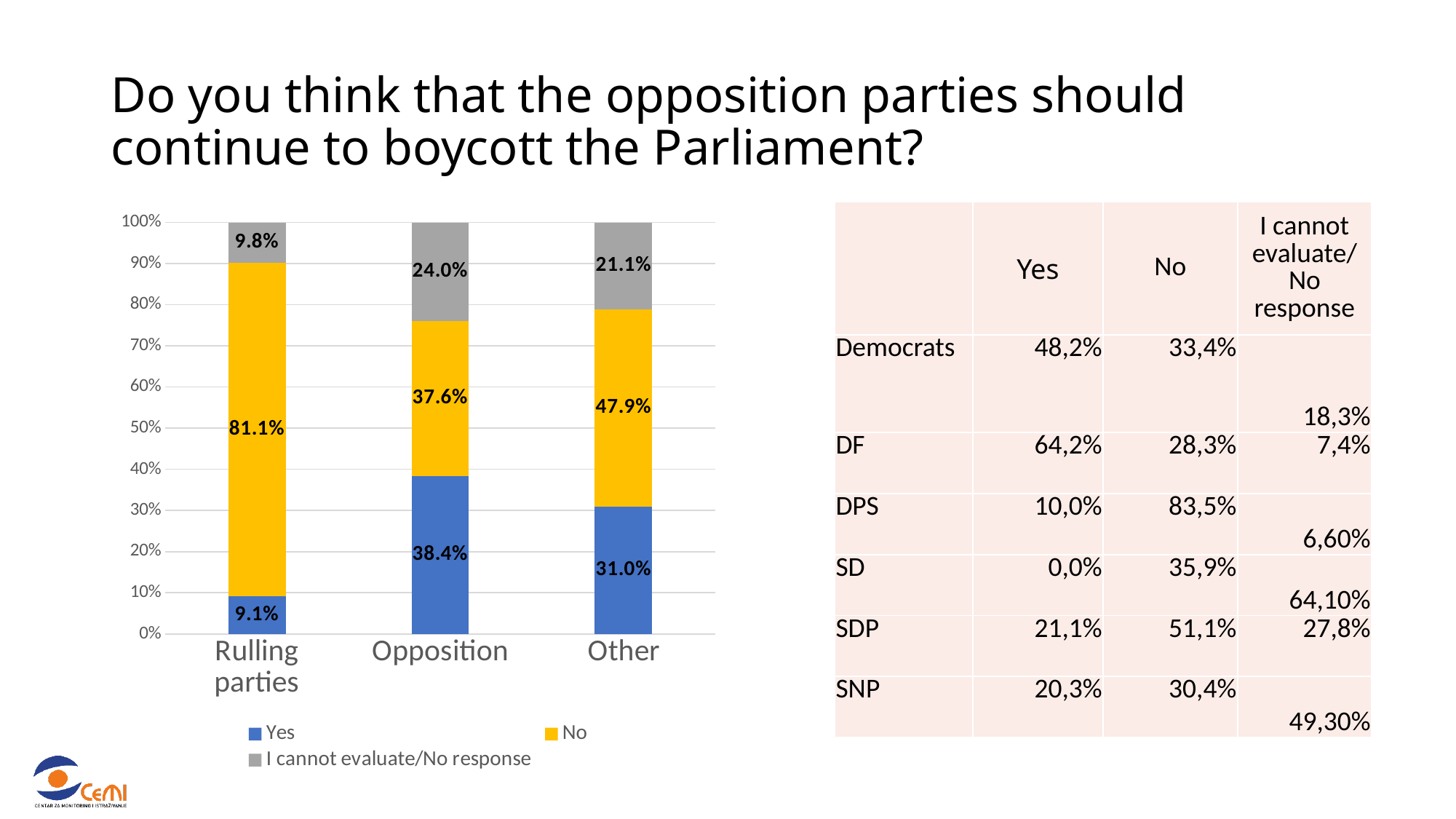
What is the difference between the No share for Rulling parties and the No share for Other? 33.2 percentage points Which category has the lowest share of No responses? Opposition How many categories are shown on the x axis of the chart? 3 Which category has the highest share of Yes responses? Opposition What is the 'I cannot evaluate/No response' share for the Other category? 21.1% Which category has the highest share of 'I cannot evaluate/No response'? Opposition Is the Yes share larger for Opposition or for Other? Opposition Which colour represents the No series in the chart? Yellow How many series does the chart legend list? 3 What type of chart is shown on the slide? Stacked bar chart What percentage of Opposition respondents answered Yes? 38.4% What percentage of Rulling parties respondents answered No? 81.1%